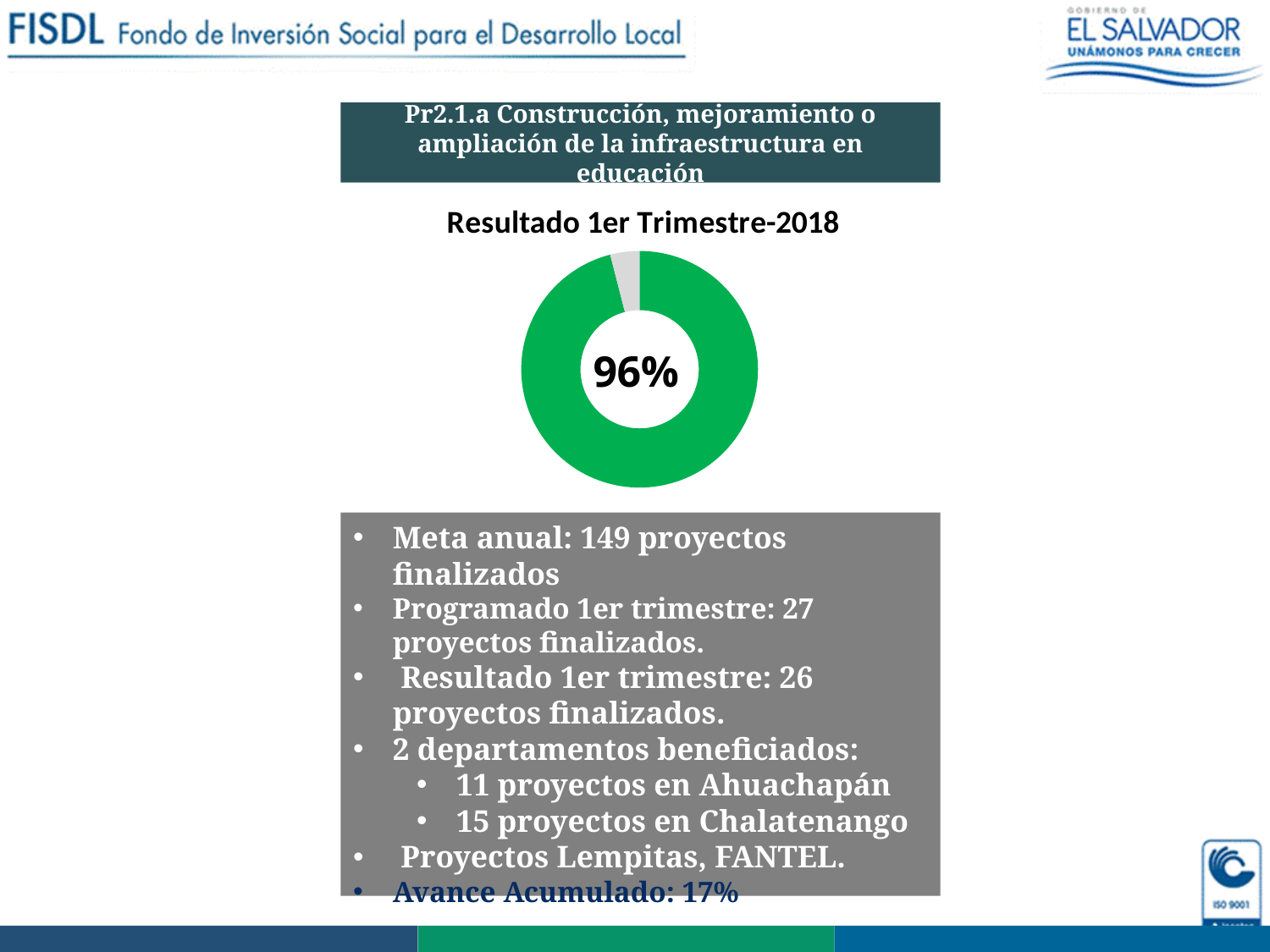
Is the share shown by the green slice of the donut chart greater or less than 50%? greater How many slices does the donut chart have? 2 What colour is the largest slice of the donut chart? Green What kind of chart is shown on the slide? Donut (pie) chart What is the title shown above the donut chart? Resultado 1er Trimestre-2018 What percentage is printed in the centre of the donut chart? 96% What share of the donut chart does the green slice represent? 96% Which slice of the donut chart is larger, the green one or the grey one? The green one